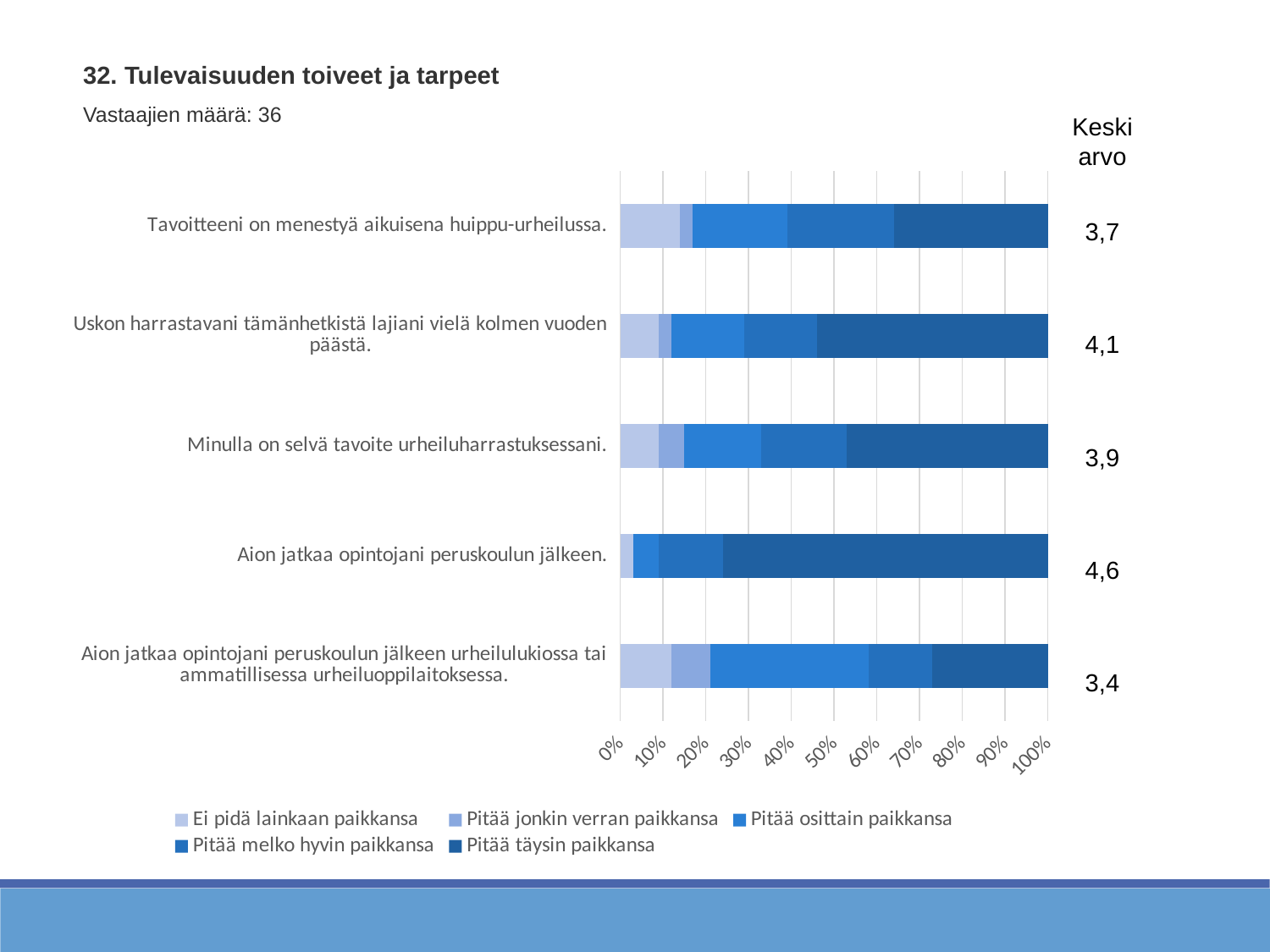
How many statements (categories) are shown in the chart? 5 Is the "Pitää täysin paikkansa" share for "Aion jatkaa opintojani peruskoulun jälkeen." greater or less than 70%? greater What is the difference between the highest and lowest mean values (Keskiarvo) shown? 1,2 Which statement has the lowest mean value (Keskiarvo)? Aion jatkaa opintojani peruskoulun jälkeen urheilulukiossa tai ammatillisessa urheiluoppilaitoksessa. Is the "Ei pidä lainkaan paikkansa" share for "Aion jatkaa opintojani peruskoulun jälkeen." greater or less than 10%? less What is the mean value (Keskiarvo) shown for "Aion jatkaa opintojani peruskoulun jälkeen."? 4,6 What is the mean value (Keskiarvo) shown for "Tavoitteeni on menestyä aikuisena huippu-urheilussa."? 3,7 Which statement has the highest mean value (Keskiarvo)? Aion jatkaa opintojani peruskoulun jälkeen. How many series does the legend list? 5 What kind of chart is shown on the slide? Stacked bar chart Which has a higher mean value: "Uskon harrastavani tämänhetkistä lajiani vielä kolmen vuoden päästä." or "Minulla on selvä tavoite urheiluharrastuksessani."? Uskon harrastavani tämänhetkistä lajiani vielä kolmen vuoden päästä. What is the mean value (Keskiarvo) shown for "Minulla on selvä tavoite urheiluharrastuksessani."? 3,9